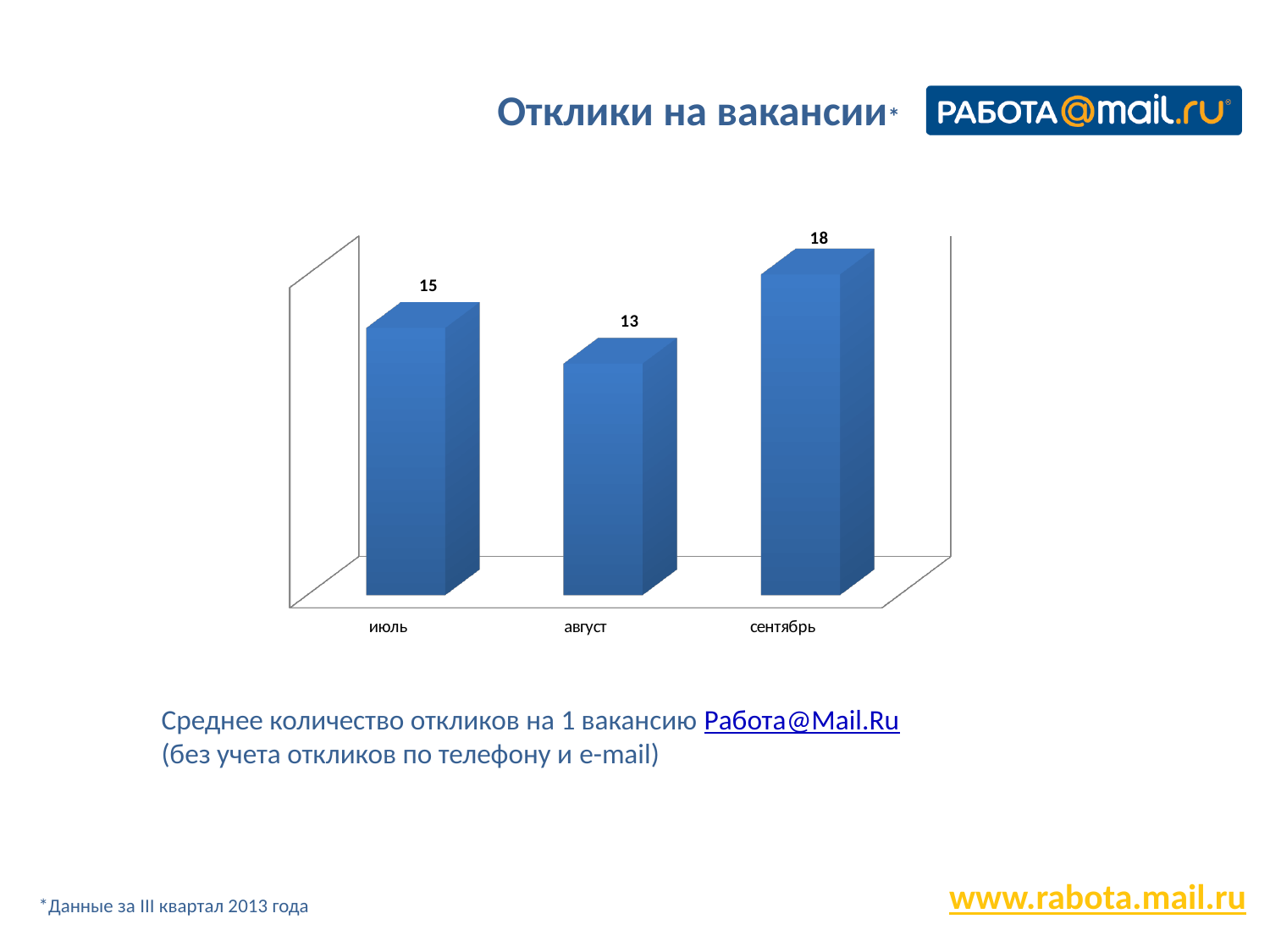
How many categories are shown on the x axis? 3 Which month has the lowest value? август What is the value for сентябрь? 18 What is the difference between the values for сентябрь and август? 5 Which is larger, the value for июль or the value for сентябрь? сентябрь What is the value for август? 13 Does the value rise or fall from август to сентябрь? rise What kind of chart is shown on the slide? bar chart What is the title of the slide's chart? Отклики на вакансии What is the difference between the values for июль and август? 2 Which month has the highest value? сентябрь What is the value for июль? 15